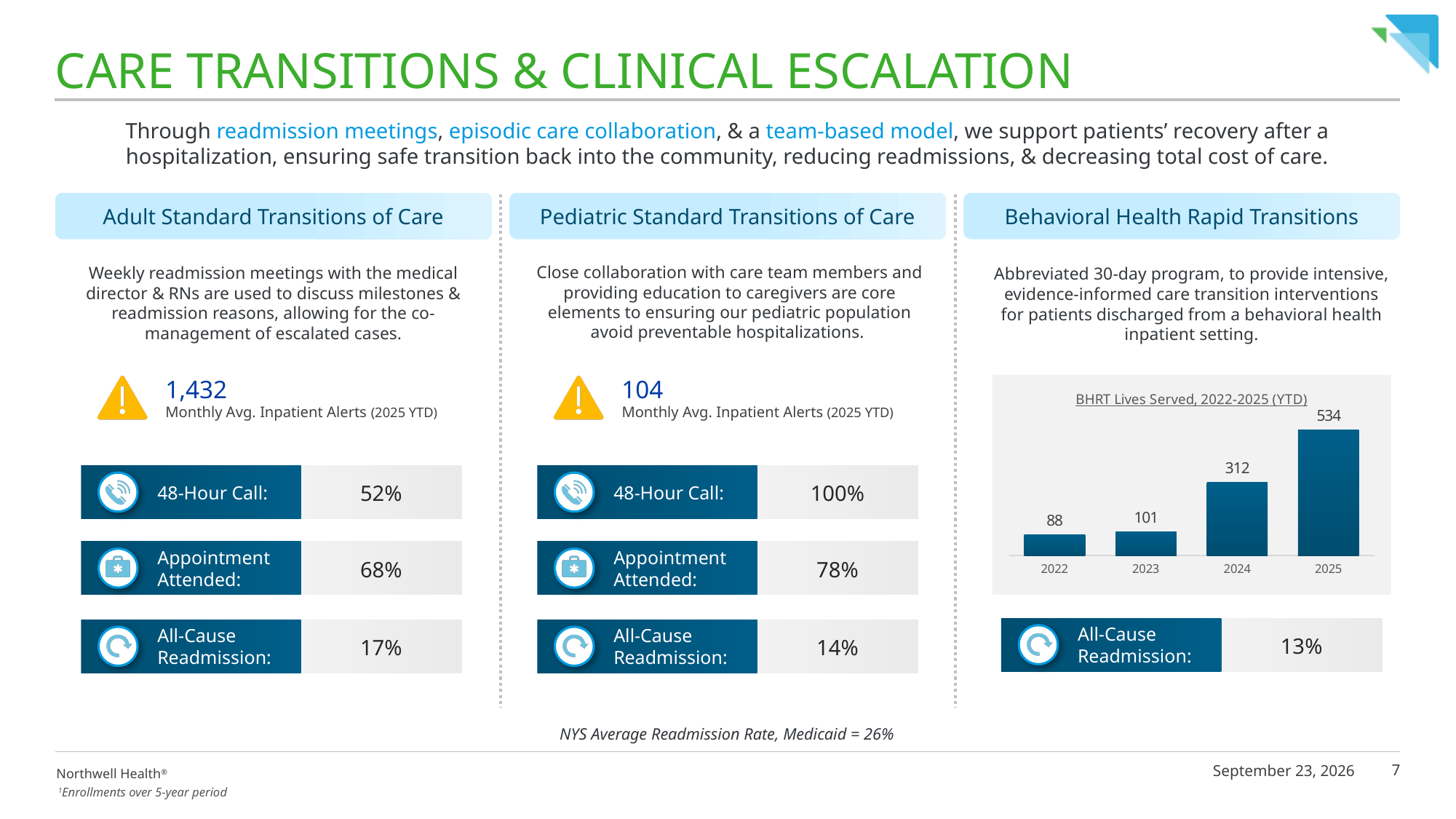
What type of chart is the BHRT Lives Served chart? bar chart Do the values in the BHRT Lives Served chart rise or fall from 2022 to 2025? rise In the BHRT Lives Served chart, which is larger, the value for 2023 or the value for 2024? 2024 What is the title of the chart on the slide? BHRT Lives Served, 2022-2025 (YTD) What is the value for 2022 in the BHRT Lives Served chart? 88 How many bars are shown in the BHRT Lives Served chart? 4 What is the value for 2025 in the BHRT Lives Served chart? 534 Which year has the lowest value in the BHRT Lives Served chart? 2022 What is the value for 2024 in the BHRT Lives Served chart? 312 What is the value for 2023 in the BHRT Lives Served chart? 101 What is the difference between the 2025 and 2024 values in the BHRT Lives Served chart? 222 Which year has the highest value in the BHRT Lives Served chart? 2025